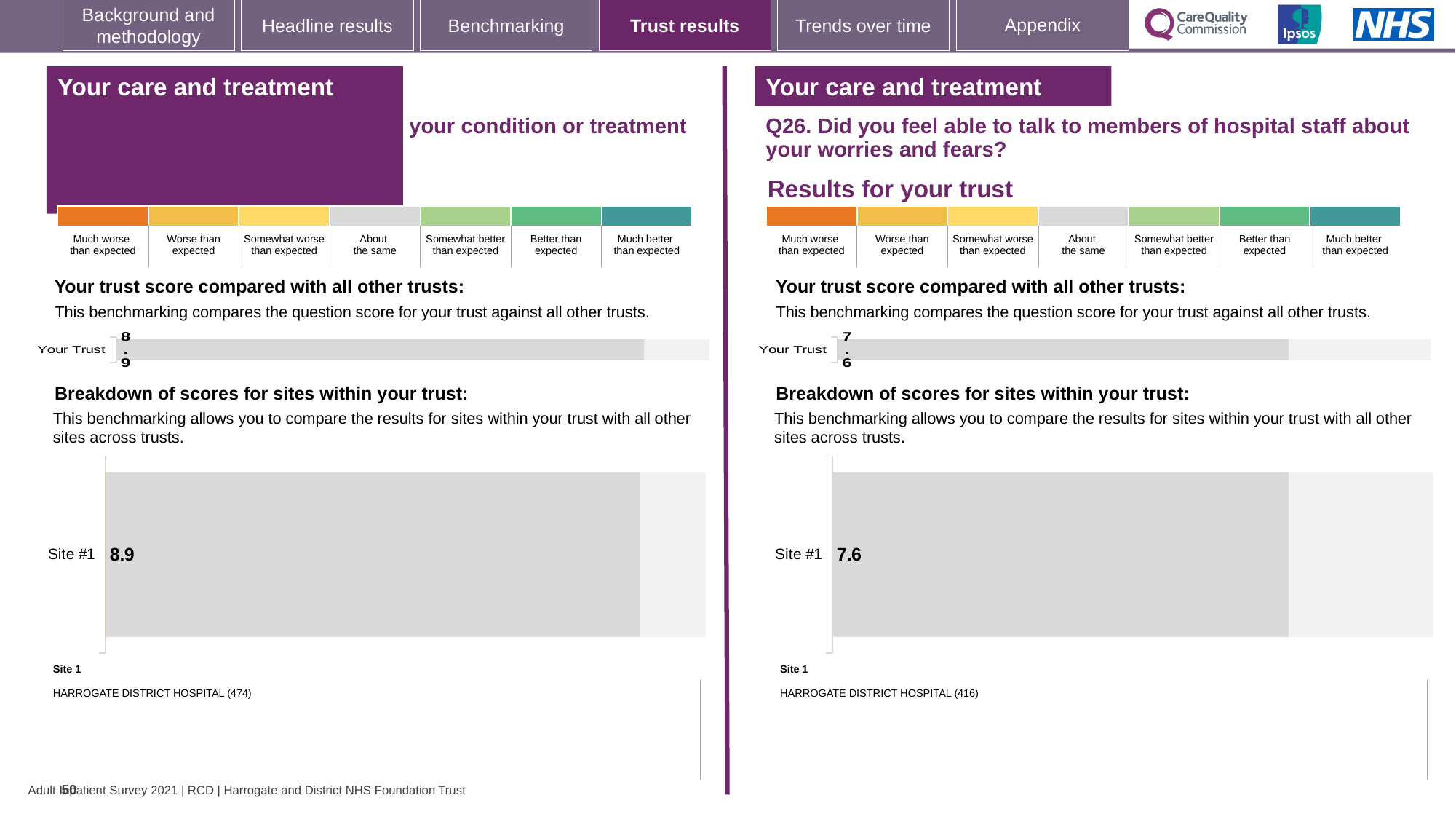
On the right panel's 'Breakdown of scores for sites within your trust' chart, what is the value for Site #1? 7.6 Which question is the right panel's chart about? Q26. Did you feel able to talk to members of hospital staff about your worries and fears? What is the difference between the Site #1 score on the left panel and the Site #1 score on the right panel? 1.3 How many sites are shown in the right panel's 'Breakdown of scores for sites within your trust' chart? 1 Which site is listed as Site 1 below the right panel's breakdown chart? HARROGATE DISTRICT HOSPITAL (416) How many bars are shown in the left panel's 'Your trust score compared with all other trusts' chart? 1 What kind of chart is used to show the Site #1 score on the right panel? Bar chart On the right panel's 'Your trust score compared with all other trusts' chart, what is the value for Your Trust? 7.6 On the left panel's 'Your trust score compared with all other trusts' chart, what is the value for Your Trust? 8.9 Which is larger: the Your Trust score on the left panel or the Your Trust score on the right panel (Q26)? Left panel On the left panel's 'Breakdown of scores for sites within your trust' chart, what is the value for Site #1? 8.9